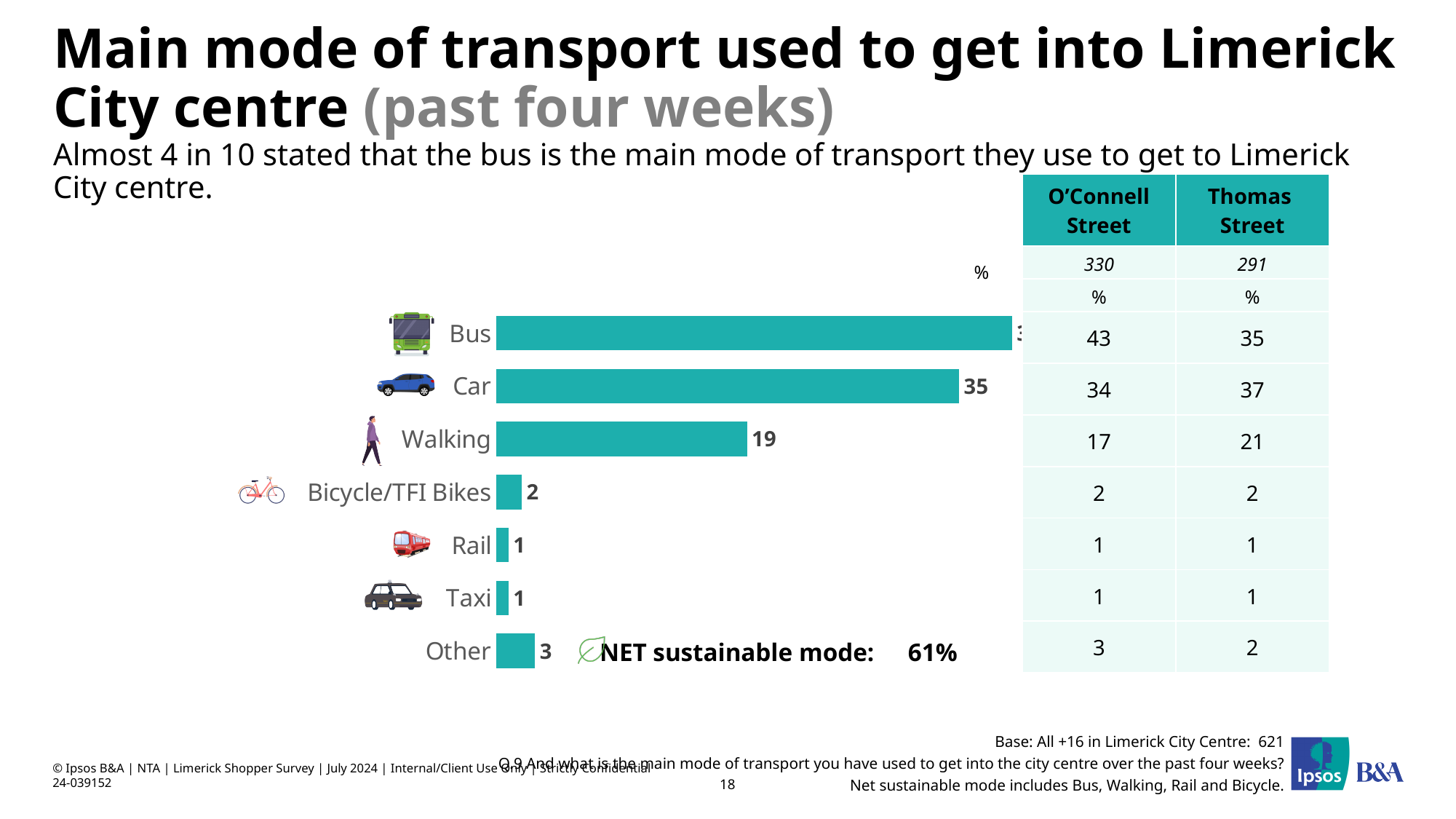
What is the value for Bicycle/TFI Bikes in the bar chart? 2 Which has the larger value in the bar chart, Walking or Other? Walking Which has the larger value in the bar chart, Car or Walking? Car Which mode of transport has the longest bar in the chart? Bus What is the value for Walking in the bar chart? 19 What is the value for Other in the bar chart? 3 What kind of chart is shown on the slide? Bar chart What is the value for Car in the bar chart? 35 How many modes of transport are shown as bars in the chart? 7 What is the difference between the values for Car and Walking in the bar chart? 16 What is the value for Rail in the bar chart? 1 What is the difference between the values for Other and Bicycle/TFI Bikes in the bar chart? 1